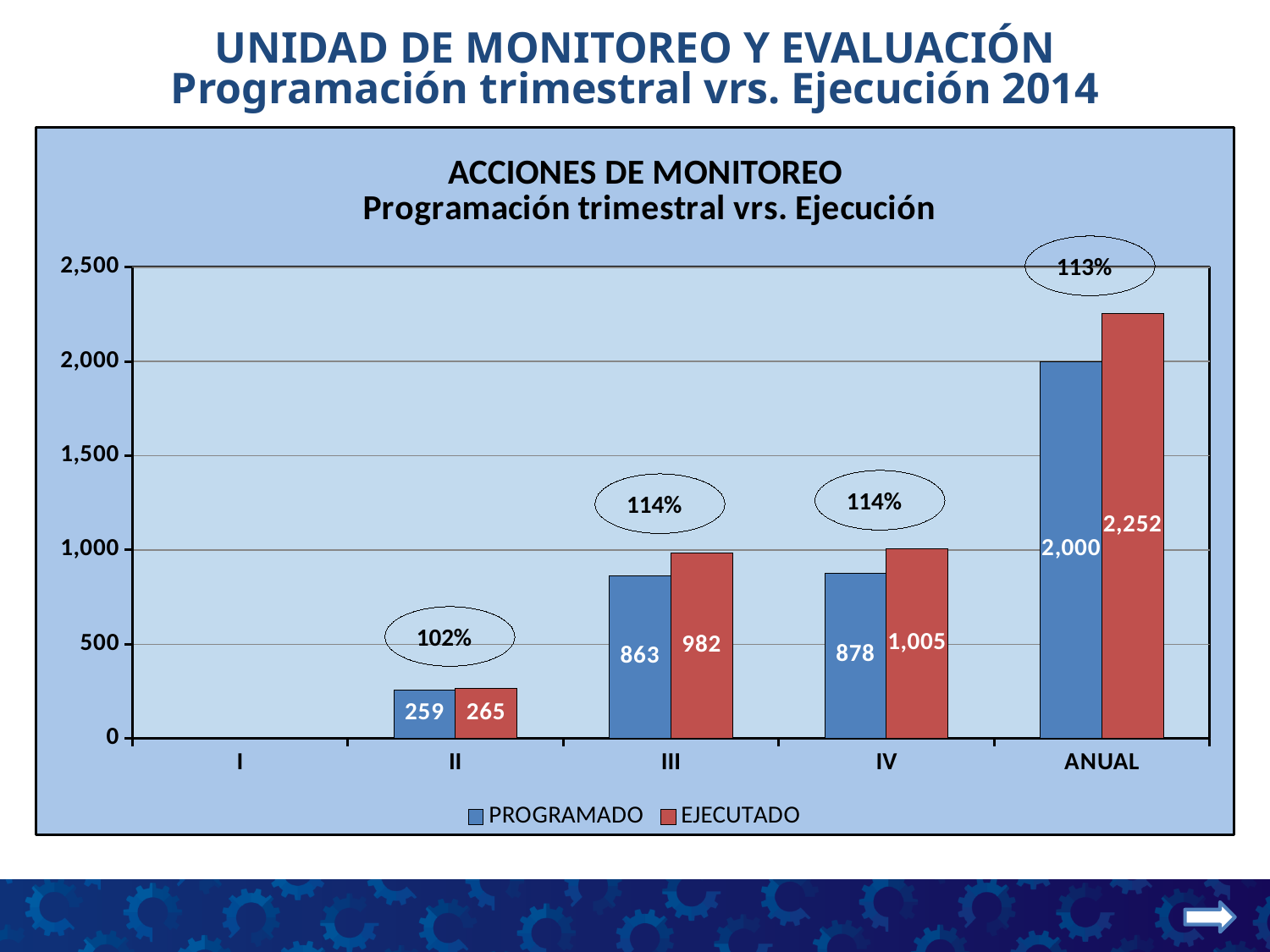
What is the PROGRAMADO value for quarter II? 259 What kind of chart is shown on the slide? Bar chart What percentage is shown in the circle above the ANUAL bars? 113% What is the difference between the EJECUTADO and PROGRAMADO values for ANUAL? 252 Which is larger for quarter III, PROGRAMADO or EJECUTADO? EJECUTADO Is the EJECUTADO value for ANUAL greater or less than 2,000? greater What is the EJECUTADO value for ANUAL? 2,252 What is the PROGRAMADO value for quarter III? 863 Which category has the highest EJECUTADO value? ANUAL How many series does the legend list? 2 Among the quarters II, III and IV, which has the lowest PROGRAMADO value? II What is the EJECUTADO value for quarter IV? 1,005